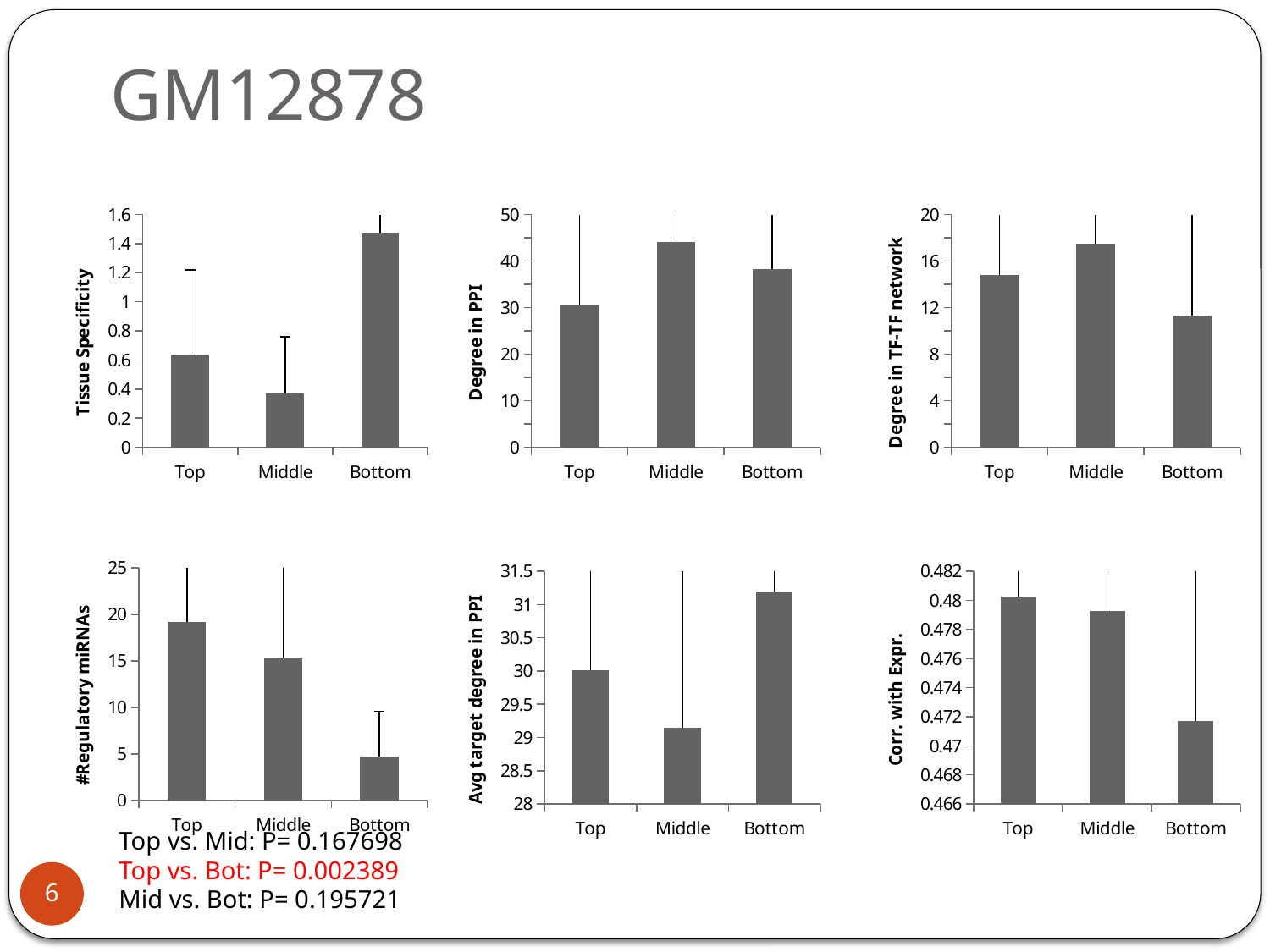
In the Avg target degree in PPI chart, which is larger, the value for Top or the value for Middle? Top In the Tissue Specificity chart, is the value for Bottom greater or less than 1.2? greater In the Corr. with Expr. chart, is the value for Bottom greater or less than 0.474? less In the Degree in PPI chart, is the value for Top greater or less than 40? less In the #Regulatory miRNAs chart, do the values rise or fall from Top to Bottom? fall How many bar charts are shown on the slide? 6 In the Degree in TF-TF network chart, which category has the lowest value? Bottom In the Tissue Specificity chart, which category has the lowest value? Middle In the Tissue Specificity chart, which category has the highest value? Bottom In the Degree in PPI chart, which category has the highest value? Middle